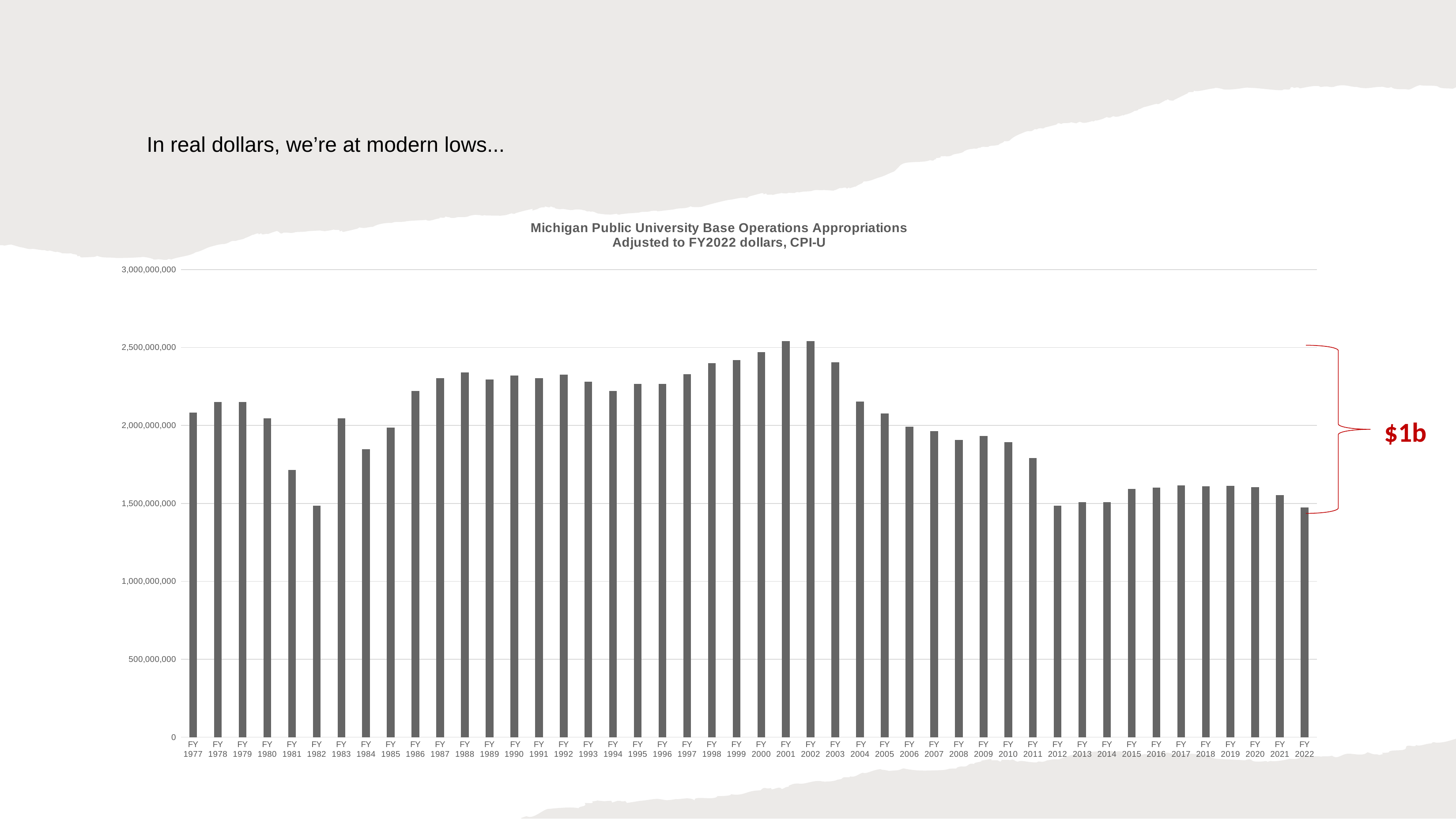
Is the value for FY 2015 greater or less than 1,500,000,000? greater What is the title of the chart? Michigan Public University Base Operations Appropriations Adjusted to FY2022 dollars, CPI-U Is the value for FY 2001 greater or less than 2,500,000,000? greater What label does the red annotation on the right side of the chart show? $1b How many fiscal years (bars) are plotted in the chart? 46 Do the values rise or fall from FY 2003 to FY 2012? fall Is the value for FY 1988 greater or less than 2,000,000,000? greater What kind of chart is shown on the slide? bar chart Which is larger, the value for FY 1982 or the value for FY 1987? FY 1987 Which is larger, the value for FY 1988 or the value for FY 2022? FY 1988